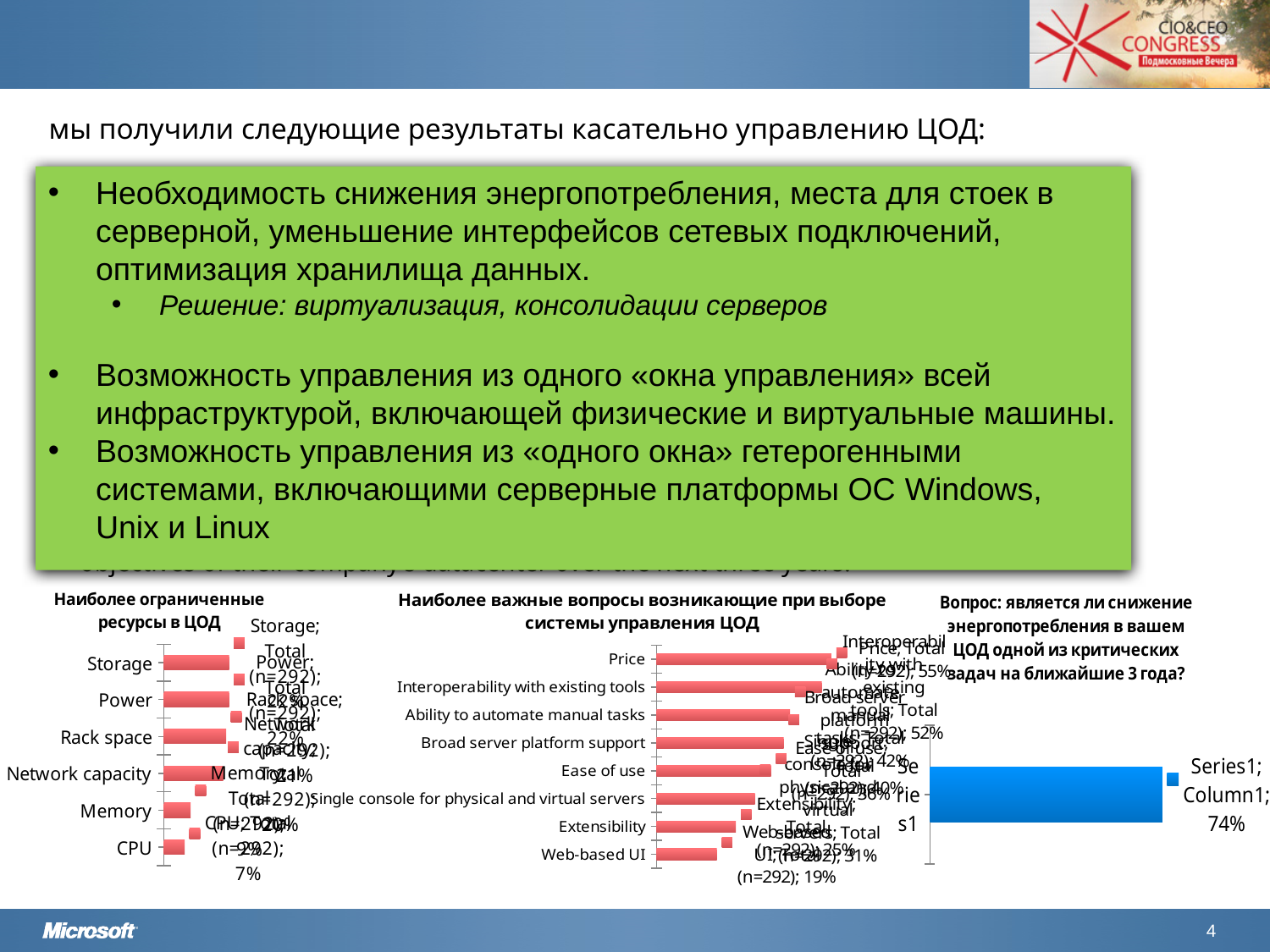
In the chart titled "Наиболее ограниченные ресурсы в ЦОД", what is the value for CPU? 7% In the chart titled "Наиболее ограниченные ресурсы в ЦОД", which is larger, the value for Storage or the value for Memory? Storage In the chart titled "Наиболее важные вопросы возникающие при выборе системы управления ЦОД", which category has the highest value? Price In the chart titled "Наиболее важные вопросы возникающие при выборе системы управления ЦОД", what is the value for Web-based UI? 19% In the chart titled "Наиболее важные вопросы возникающие при выборе системы управления ЦОД", what is the difference between the values for Price and Web-based UI? 36% In the chart titled "Наиболее важные вопросы возникающие при выборе системы управления ЦОД", how many categories are plotted? 8 In the chart titled "Наиболее ограниченные ресурсы в ЦОД", which category has the highest value? Storage and Power (both 22%) In the chart titled "Наиболее ограниченные ресурсы в ЦОД", how many categories are plotted? 6 In the chart titled "Наиболее важные вопросы возникающие при выборе системы управления ЦОД", which category has the lowest value? Web-based UI In the chart on the right of the slide (about reducing energy consumption in the data center), what value is shown on the bar? 74% In the chart titled "Наиболее важные вопросы возникающие при выборе системы управления ЦОД", what is the value for Price? 55% In the chart titled "Наиболее ограниченные ресурсы в ЦОД", which category has the lowest value? CPU